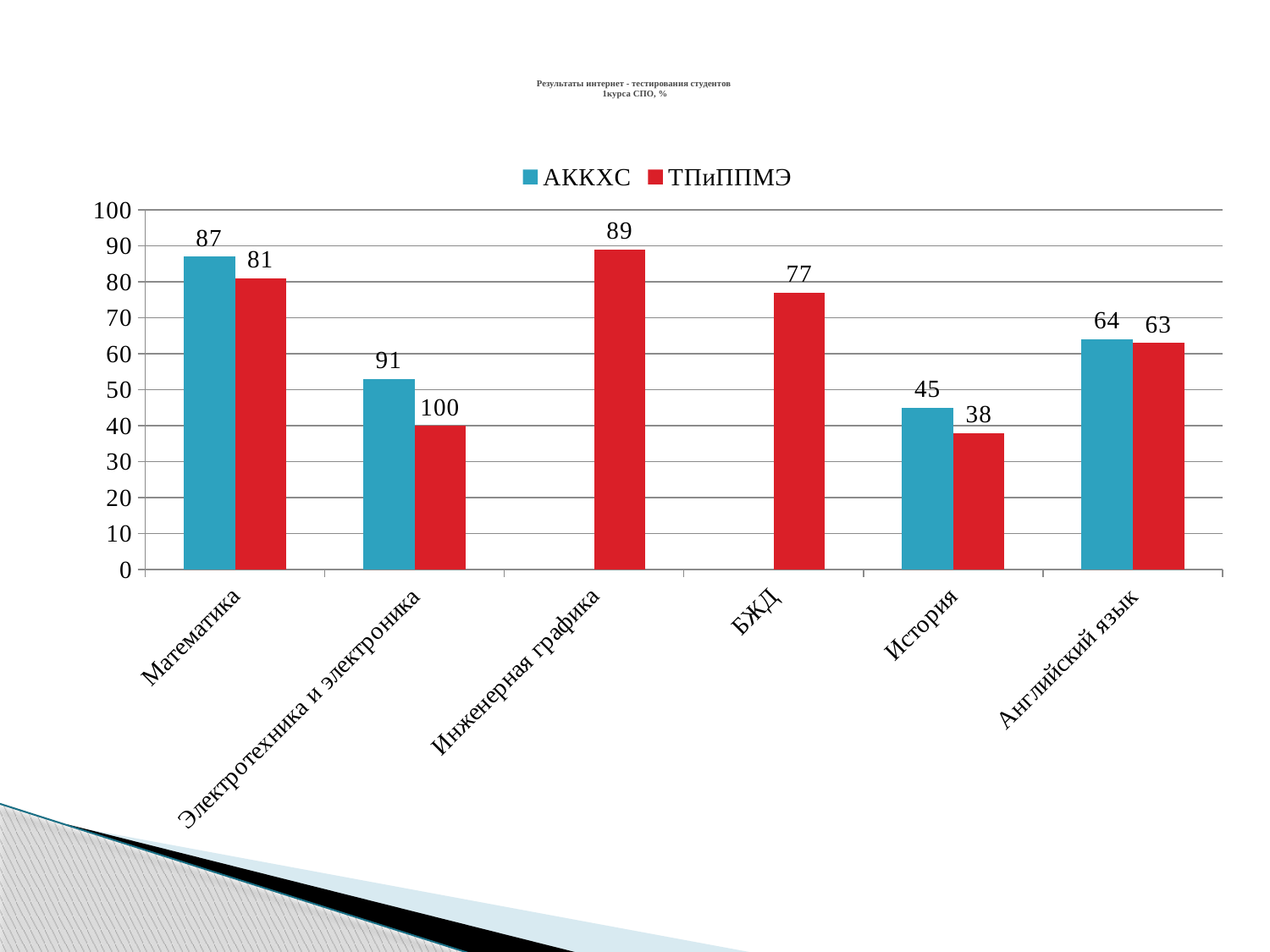
What is the difference between the АККХС and ТПиППМЭ values for Математика? 6 What kind of chart is shown on the slide? bar chart How many series does the legend list? 2 How many categories have a bar for ТПиППМЭ only and no bar for АККХС? 2 Which series has the larger value for История, АККХС or ТПиППМЭ? АККХС How many categories are shown on the x axis? 6 What is the value for АККХС in Математика? 87 What is the value for ТПиППМЭ in Инженерная графика? 89 What are the two series named in the legend? АККХС and ТПиППМЭ What is the value for ТПиППМЭ in История? 38 Is the value for ТПиППМЭ in БЖД greater or less than 70? greater What is the value for АККХС in Английский язык? 64